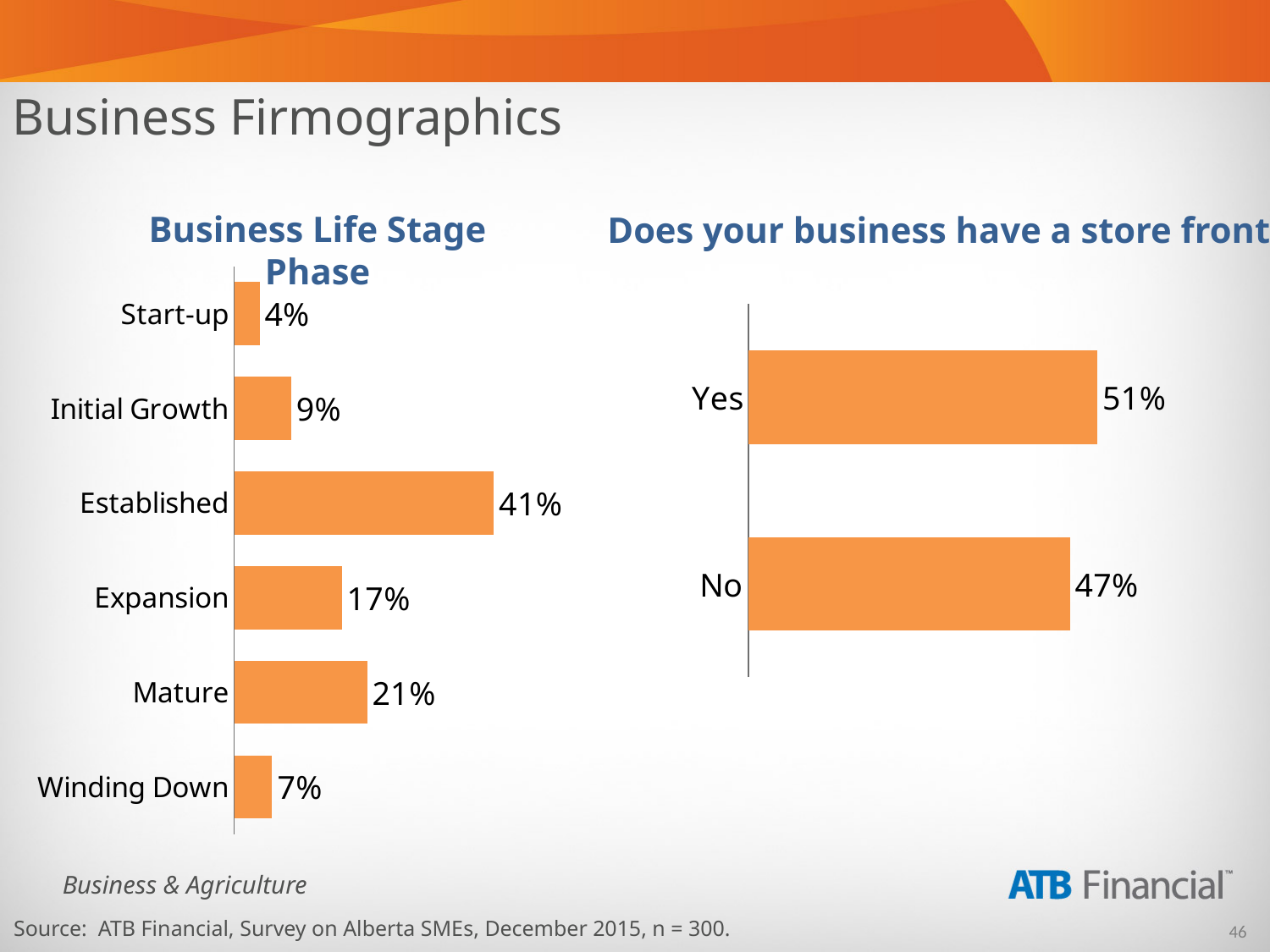
In the Business Life Stage Phase chart, what is the value for Mature? 21% In the Business Life Stage Phase chart, what percentage of businesses are in the Established phase? 41% What is the title of the chart on the right side of the slide? Does your business have a store front What kind of chart is the Business Life Stage Phase chart? Bar chart In the Business Life Stage Phase chart, which is larger, Initial Growth or Winding Down? Initial Growth In the Business Life Stage Phase chart, which phase has the highest percentage? Established In the Business Life Stage Phase chart, what is the difference between the Established and Expansion values? 24% In the 'Does your business have a store front' chart, which response is larger, Yes or No? Yes How many phases are shown in the Business Life Stage Phase chart? 6 In the 'Does your business have a store front' chart, what is the difference between Yes and No? 4% In the Business Life Stage Phase chart, which phase has the lowest percentage? Start-up In the 'Does your business have a store front' chart, what percentage answered Yes? 51%